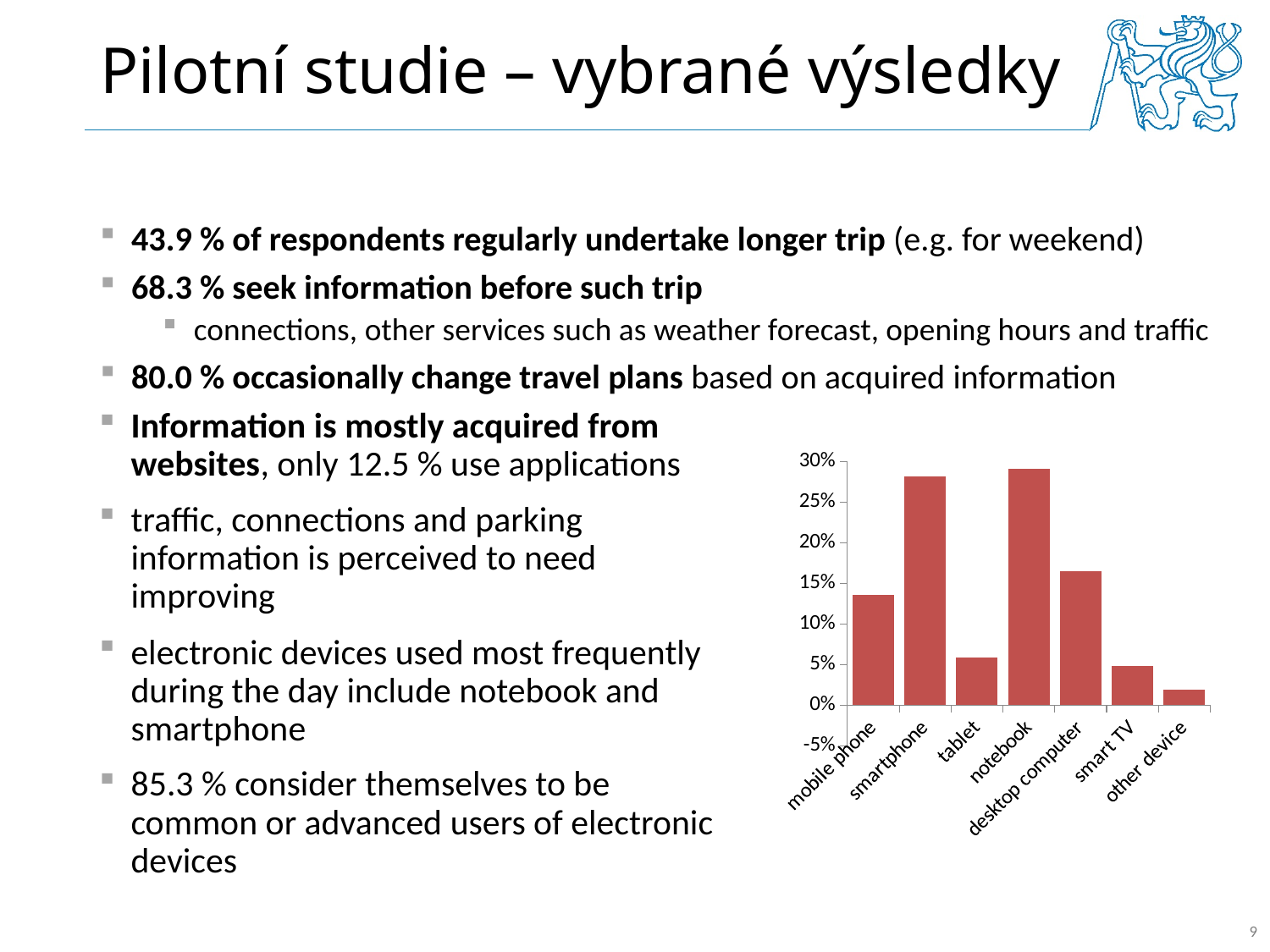
How many device categories are shown on the x axis of the chart? 7 Which has the larger value in the chart, desktop computer or mobile phone? desktop computer Is the value for notebook greater or less than 25%? greater Is the value for other device greater or less than 5%? less Is the value for smartphone greater or less than 25%? greater Which device category has the lowest bar in the chart? other device Which has the larger value in the chart, smartphone or tablet? smartphone What is the highest tick value shown on the chart's vertical axis? 30% What kind of chart is shown on the slide? bar chart